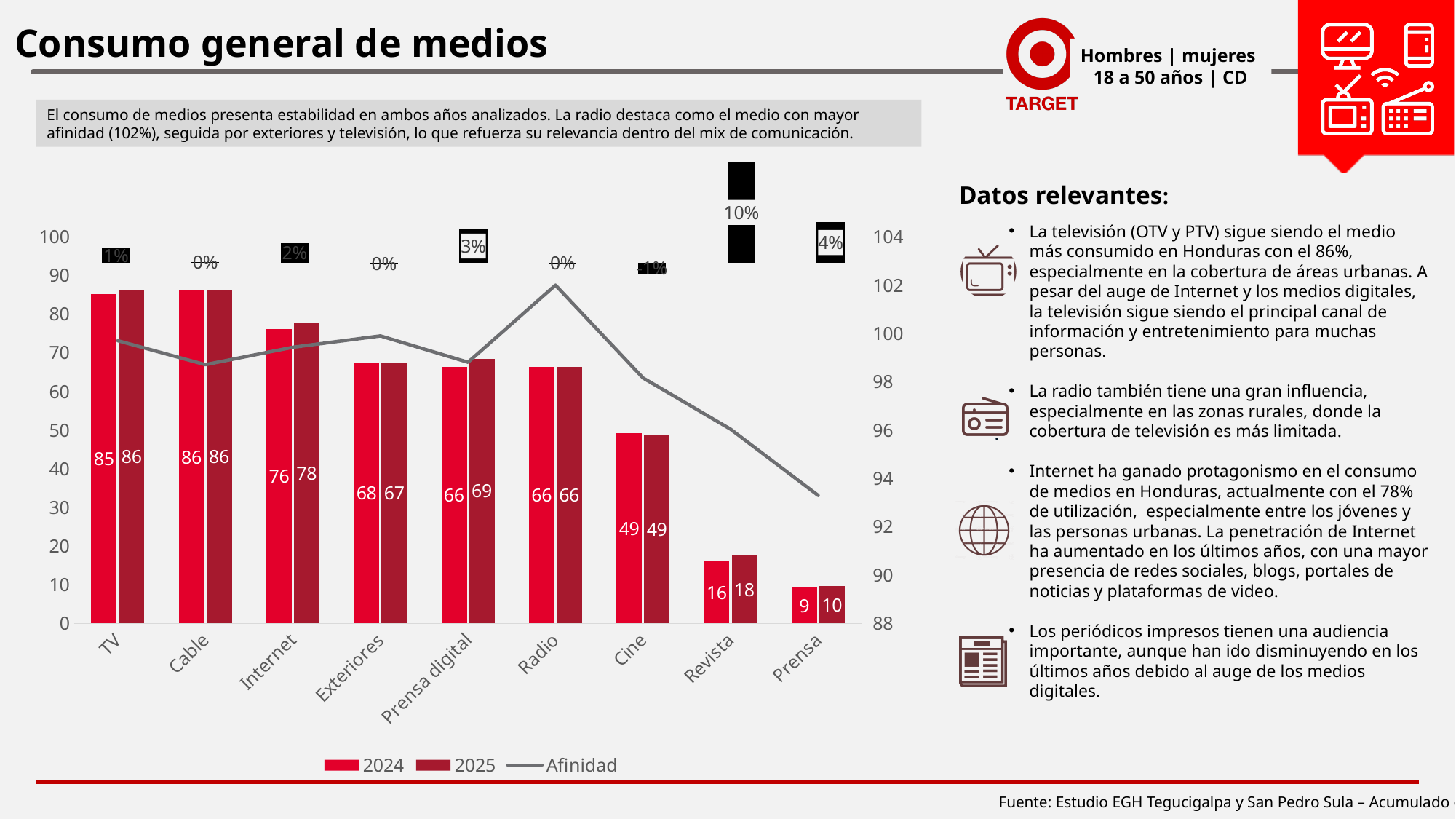
Is the Afinidad value for Radio greater or less than 100? greater What is the 2024 value for Revista? 16 Which category has the lowest 2025 value? Prensa Which category has the highest 2024 value? Cable What is the difference between the 2025 and 2024 values for Revista? 2 What is the difference between the 2025 values for TV and Cine? 37 For Exteriores, which series has the larger value, 2024 or 2025? 2024 How many categories are shown on the x axis? 9 Do the 2025 bar values rise or fall from TV to Prensa along the x axis? fall How many series does the legend list? 3 What kind of chart is used for the 2024 and 2025 series? bar chart What is the 2025 value for Internet? 78